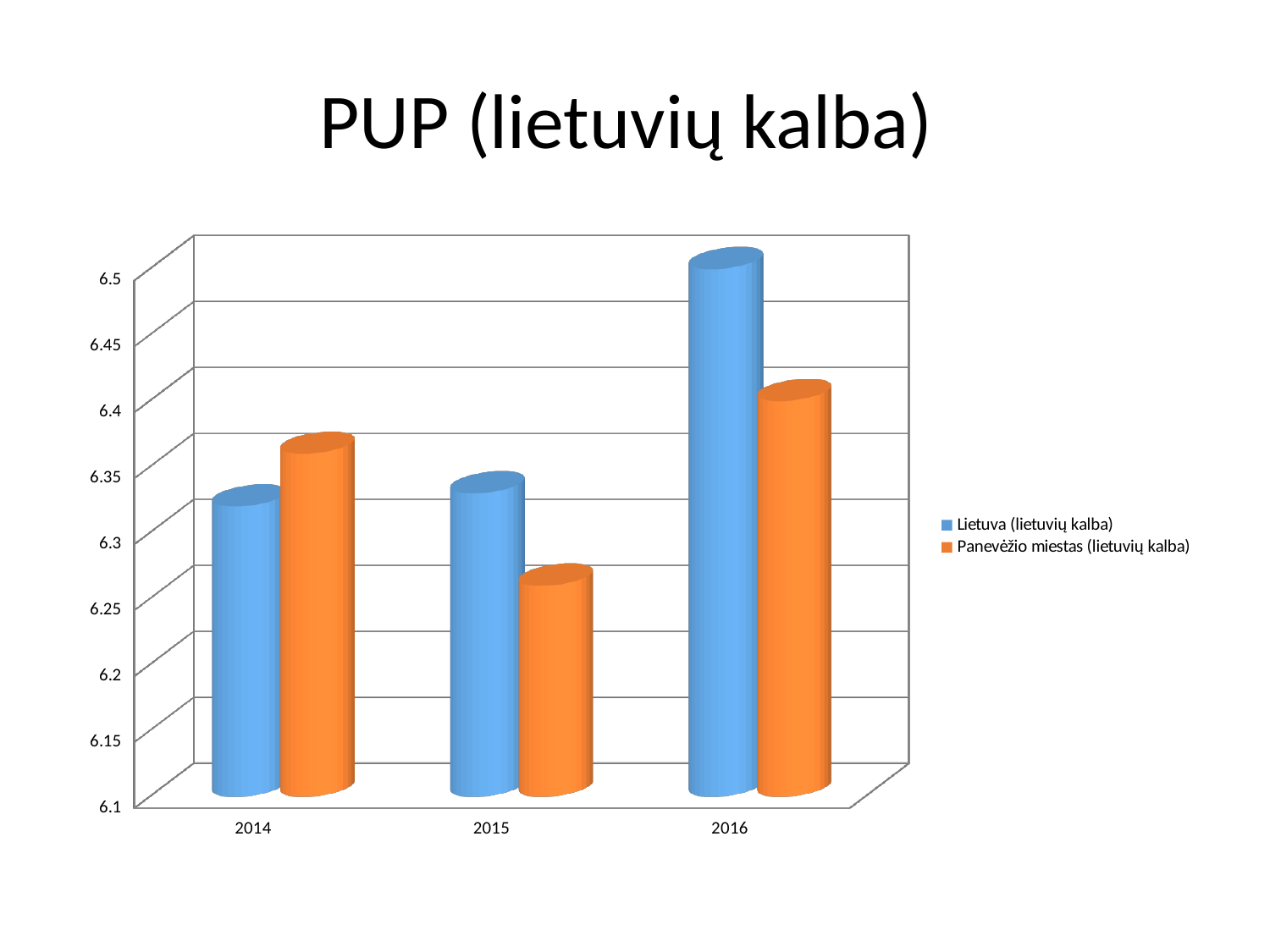
Does the value for Lietuva (lietuvių kalba) rise or fall from 2014 to 2016? rise In 2014, which series has the larger value, Lietuva (lietuvių kalba) or Panevėžio miestas (lietuvių kalba)? Panevėžio miestas (lietuvių kalba) In 2015, which series has the larger value, Lietuva (lietuvių kalba) or Panevėžio miestas (lietuvių kalba)? Lietuva (lietuvių kalba) Is the value for Panevėžio miestas (lietuvių kalba) in 2015 greater or less than 6.3? less In which year is the value for Lietuva (lietuvių kalba) highest? 2016 How many years are shown on the x axis? 3 What is the title of the slide? PUP (lietuvių kalba) Is the value for Lietuva (lietuvių kalba) in 2016 greater or less than 6.45? greater In 2016, which series has the larger value, Lietuva (lietuvių kalba) or Panevėžio miestas (lietuvių kalba)? Lietuva (lietuvių kalba) What kind of chart is shown on the slide? bar chart How many series does the legend list? 2 In which year is the value for Panevėžio miestas (lietuvių kalba) lowest? 2015